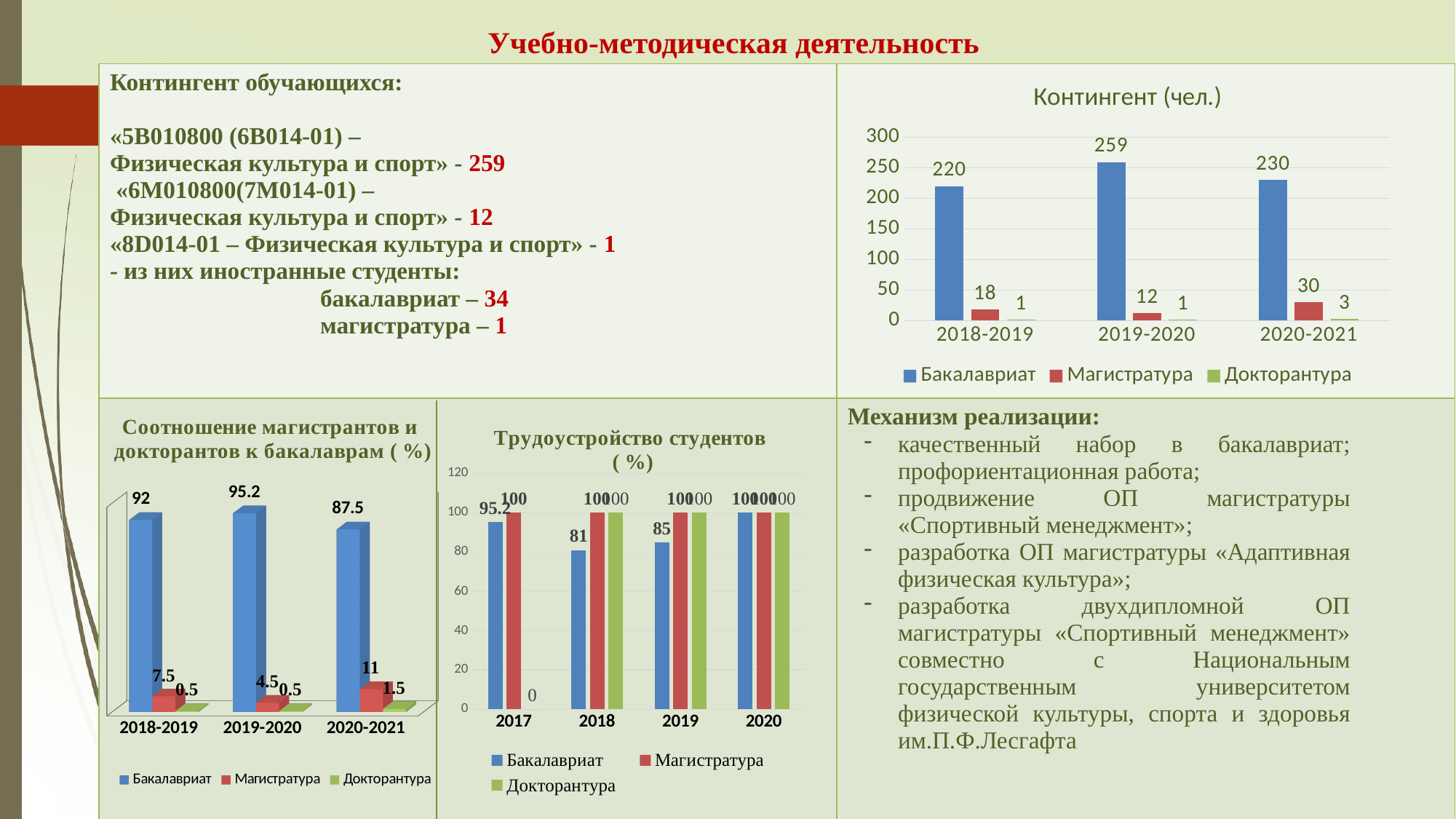
In the chart titled "Контингент (чел.)", what is the value for Магистратура in 2020-2021? 30 In the chart titled "Соотношение магистрантов и докторантов к бакалаврам ( %)", which year has the lowest Магистратура value? 2019-2020 In the chart titled "Контингент (чел.)", what is the value for Докторантура in 2020-2021? 3 In the chart titled "Соотношение магистрантов и докторантов к бакалаврам ( %)", what is the value for Бакалавриат in 2020-2021? 87.5 In the chart titled "Контингент (чел.)", what is the value for Бакалавриат in 2019-2020? 259 In the chart titled "Соотношение магистрантов и докторантов к бакалаврам ( %)", what is the value for Докторантура in 2020-2021? 1.5 In the chart titled "Контингент (чел.)", which year has the highest Бакалавриат value? 2019-2020 In the chart titled "Трудоустройство студентов ( %)", what is the value for Докторантура in 2017? 0 In the chart titled "Контингент (чел.)", what is the difference between the Бакалавриат values for 2019-2020 and 2018-2019? 39 In the chart titled "Трудоустройство студентов ( %)", what is the value for Бакалавриат in 2018? 81 What kind of chart is the chart titled "Трудоустройство студентов ( %)"? bar chart In the chart titled "Контингент (чел.)", how many series does the legend list? 3